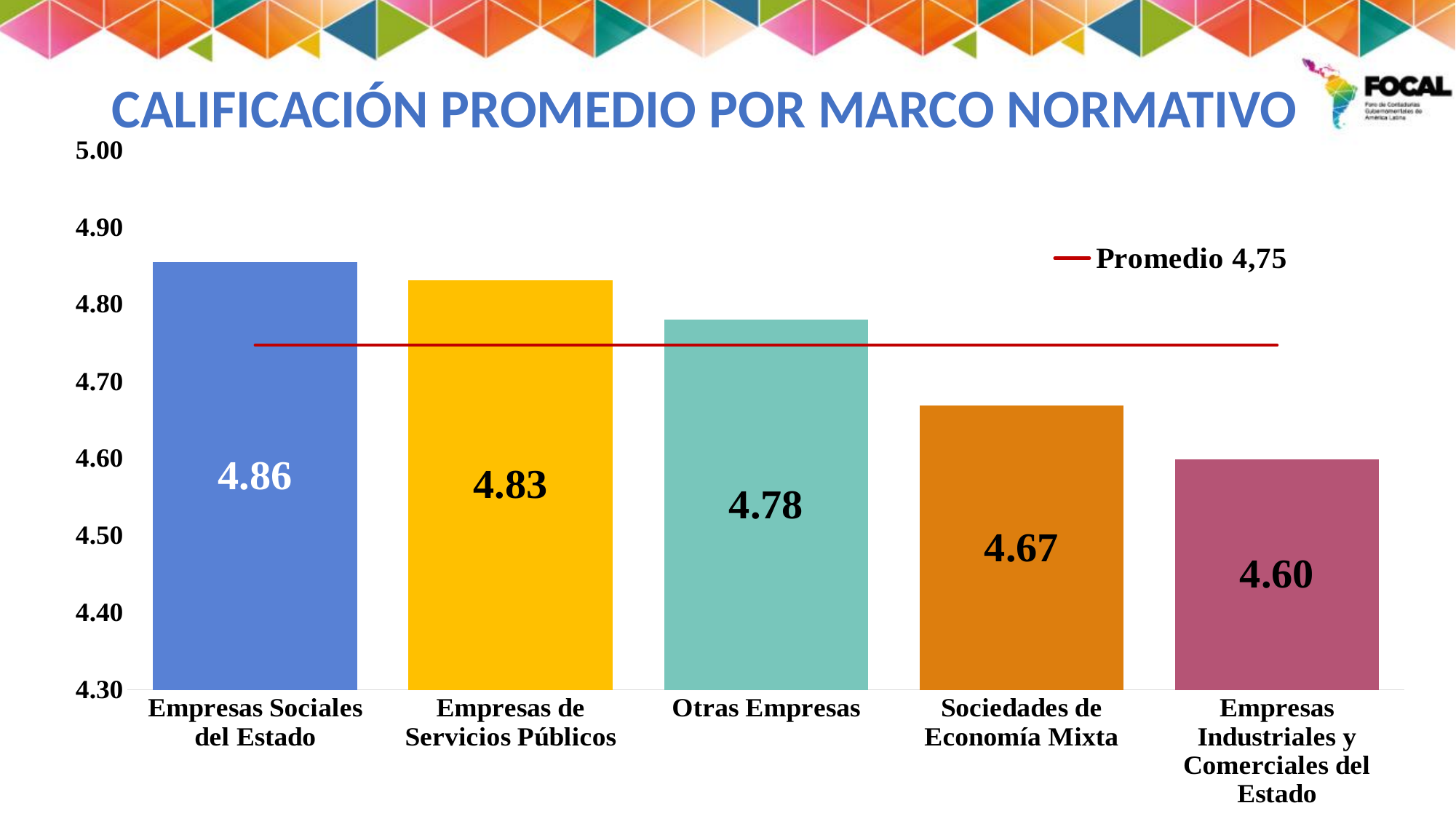
What kind of chart is shown on the slide? bar chart Which is larger, the value for Empresas de Servicios Públicos or the value for Sociedades de Economía Mixta? Empresas de Servicios Públicos Which category has the highest value? Empresas Sociales del Estado What is the value for Sociedades de Economía Mixta? 4.67 Which category has the lowest value? Empresas Industriales y Comerciales del Estado What is the value for Otras Empresas? 4.78 What is the value for Empresas Sociales del Estado? 4.86 Do the values rise or fall from left to right along the x axis? fall How many categories are shown in the chart? 5 Is the value for Sociedades de Economía Mixta greater or less than 4.70? less What value does the red horizontal line labelled Promedio represent? 4,75 What is the difference between the values for Empresas Sociales del Estado and Empresas Industriales y Comerciales del Estado? 0.26